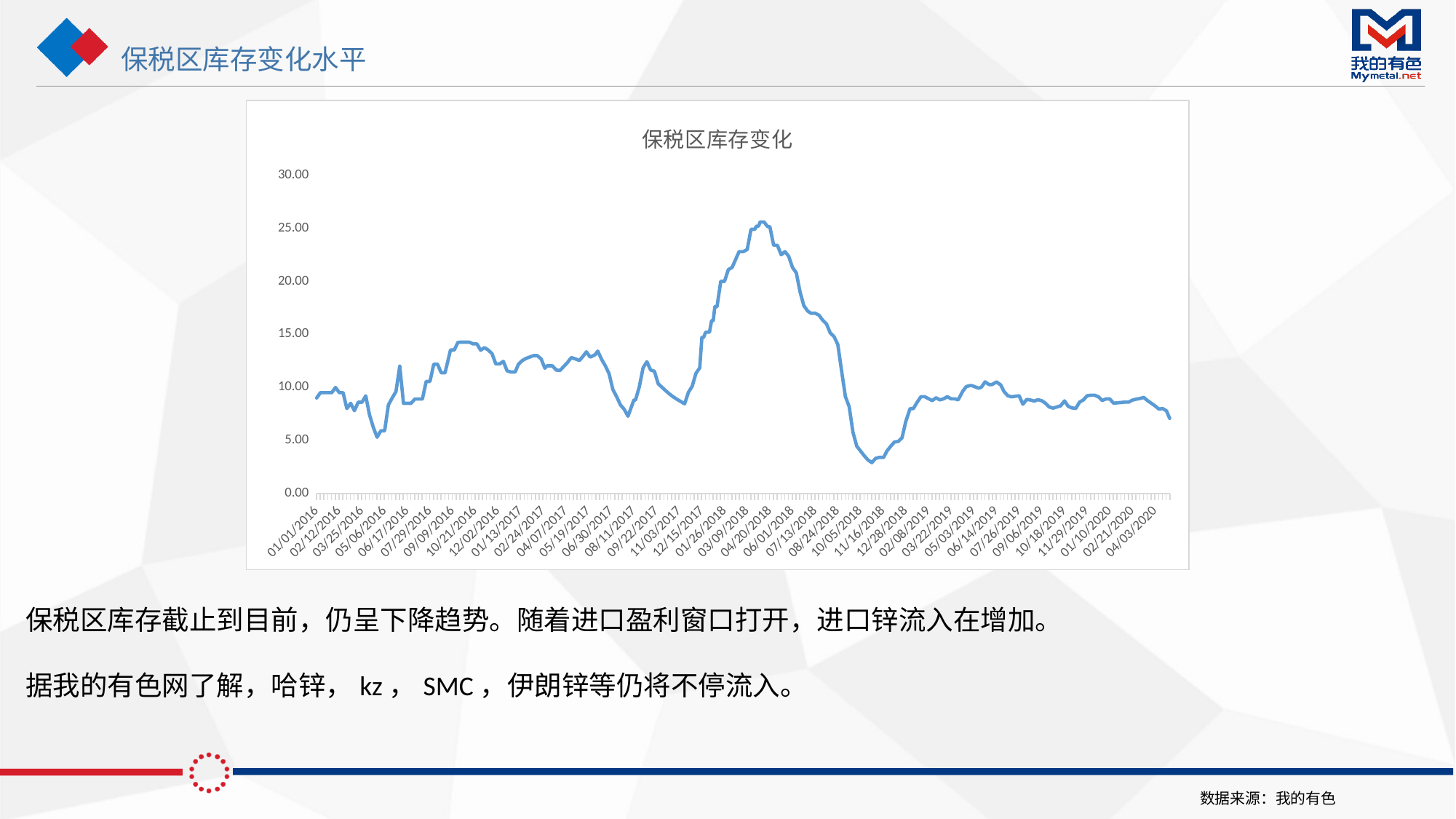
What is the title of the chart? 保税区库存变化 What is the highest value shown on the vertical axis of the chart? 30.00 Which is larger, the value around 04/20/2018 or the value around 11/16/2018? 04/20/2018 Is the value around 04/20/2018 greater or less than 20.00? greater Around which date on the x axis does the line reach its highest point? 04/20/2018 What kind of chart is shown on the slide? line chart Is the value at 04/03/2020 greater or less than 10.00? less Around which date on the x axis does the line reach its lowest point? 11/16/2018 Is the value around 11/16/2018 greater or less than 5.00? less Between 04/20/2018 and 11/16/2018, does the line rise or fall? fall